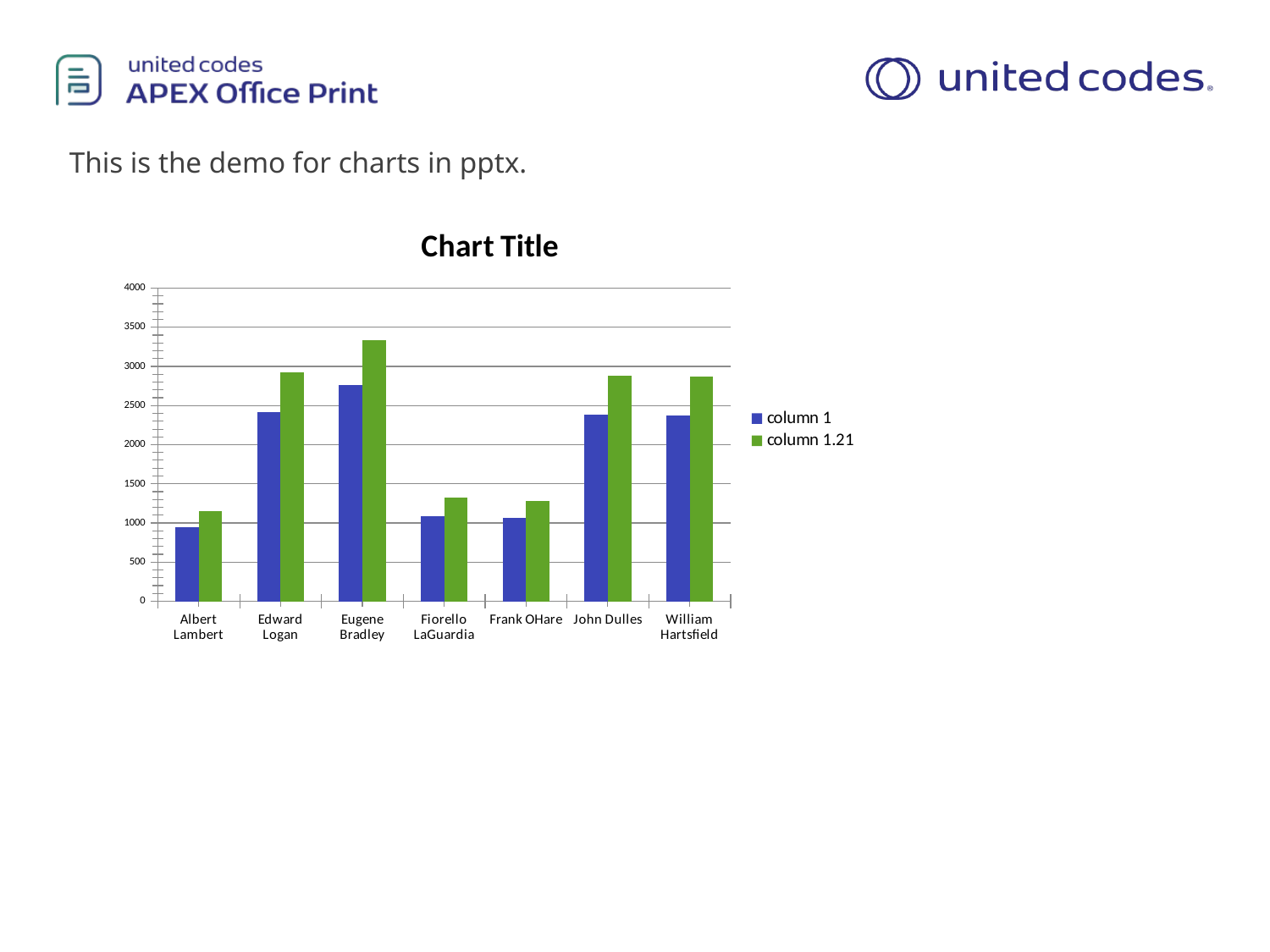
How many series does the chart legend list? 2 Which category has the highest value for the column 1.21 series? Eugene Bradley Which is larger for Edward Logan: the column 1 value or the column 1.21 value? column 1.21 Is the column 1.21 value for Fiorello LaGuardia greater or less than 1000? greater Which category has the lowest value for the column 1.21 series? Albert Lambert How many categories are shown on the x axis of the chart? 7 Which category has the highest value for the column 1 series? Eugene Bradley What kind of chart is shown on the slide? bar chart Is the column 1.21 value for Eugene Bradley greater or less than 3000? greater What is the title of the chart? Chart Title Is the column 1 value for Edward Logan greater or less than 2500? less